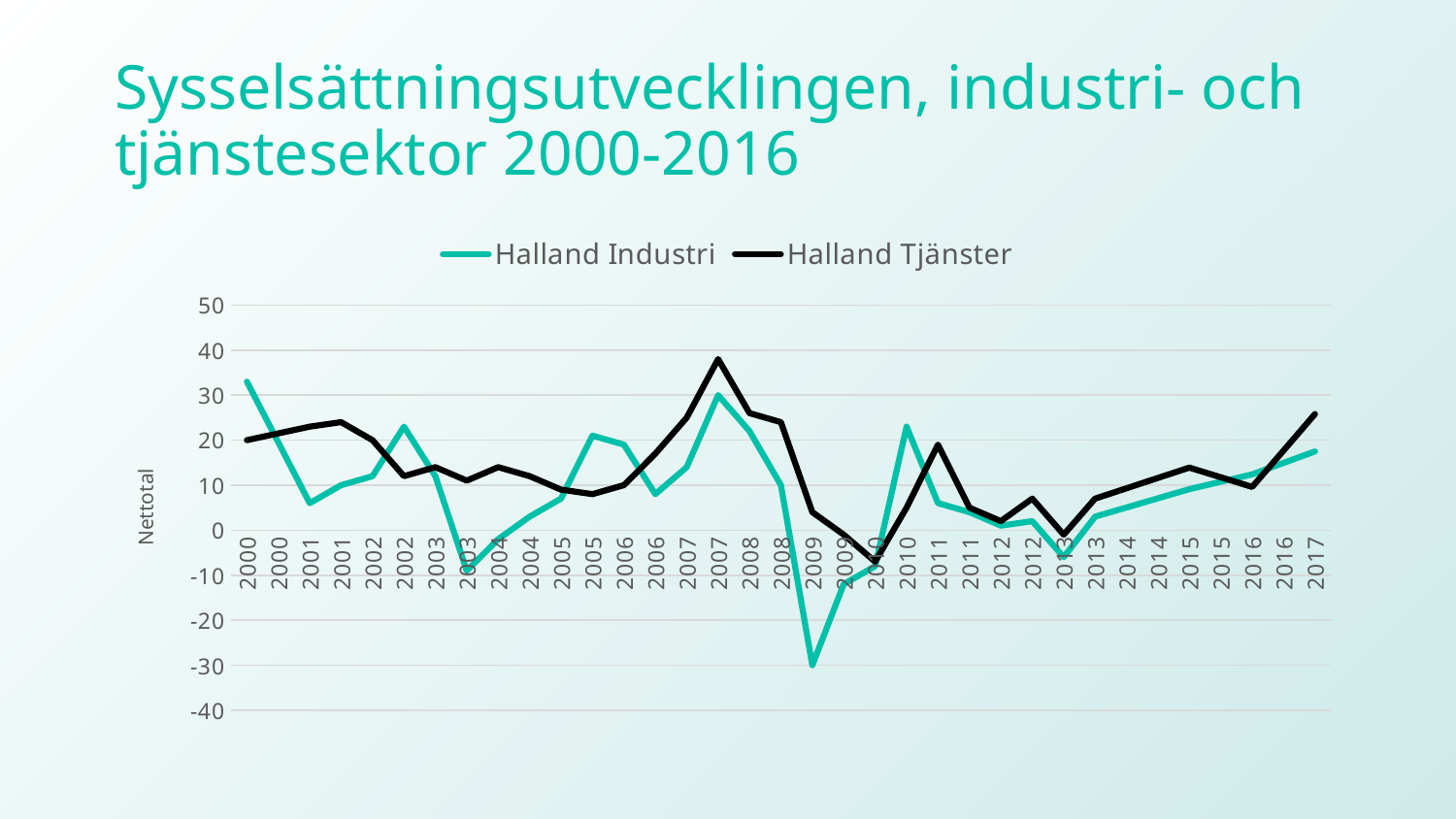
Does the Halland Tjänster line rise or fall between 2016 and 2017? rise What is the title of the chart on the slide? Sysselsättningsutvecklingen, industri- och tjänstesektor 2000-2016 What kind of chart is shown on the slide? line chart In which year does the Halland Industri line reach its lowest value? 2009 Is the lowest value of Halland Industri (in 2009) greater or less than -20? less What is the label on the vertical axis? Nettotal Is the value of Halland Tjänster at 2017 greater or less than 20? greater At the second 2010 point, which series is higher, Halland Industri or Halland Tjänster? Halland Industri Is the peak value of Halland Tjänster in 2007 greater or less than 30? greater How many series does the legend list? 2 At the 2007 peak, which series has the higher value, Halland Industri or Halland Tjänster? Halland Tjänster In which year does the Halland Tjänster line reach its highest value? 2007